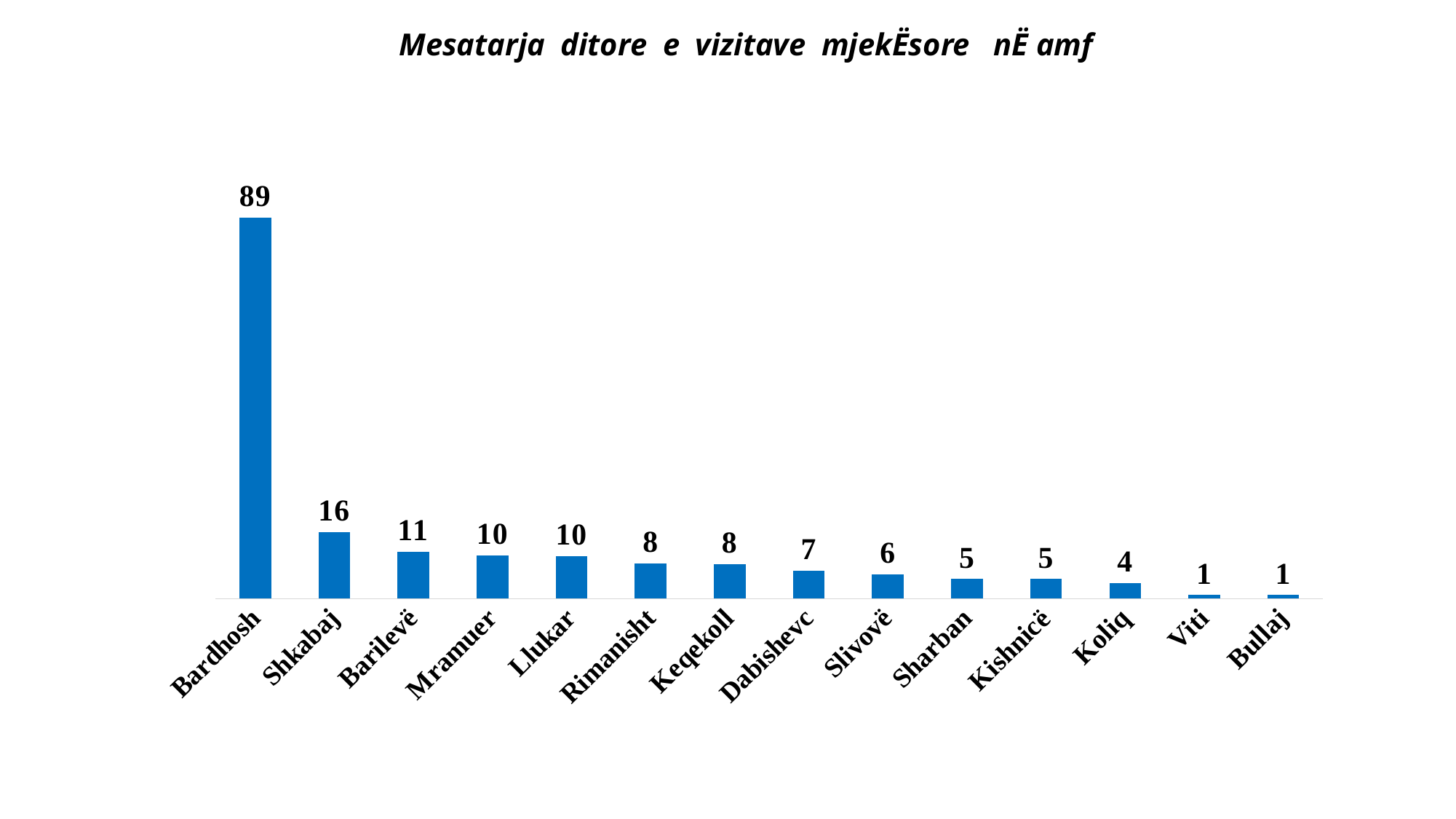
What is the difference between the values for Bardhosh and Shkabaj? 73 Do the values rise or fall from left to right along the x axis? Fall What is the value for Dabishevc? 7 What kind of chart is shown on the slide? Bar chart How many categories are shown on the x axis? 14 Which is larger, the value for Rimanisht or the value for Sharban? Rimanisht What is the value for Shkabaj? 16 What is the value for Bardhosh? 89 Which category has the highest value? Bardhosh What is the title of the chart? Mesatarja ditore e vizitave mjekËsore nË amf What is the difference between the values for Barilevë and Slivovë? 5 What is the value for Koliq? 4